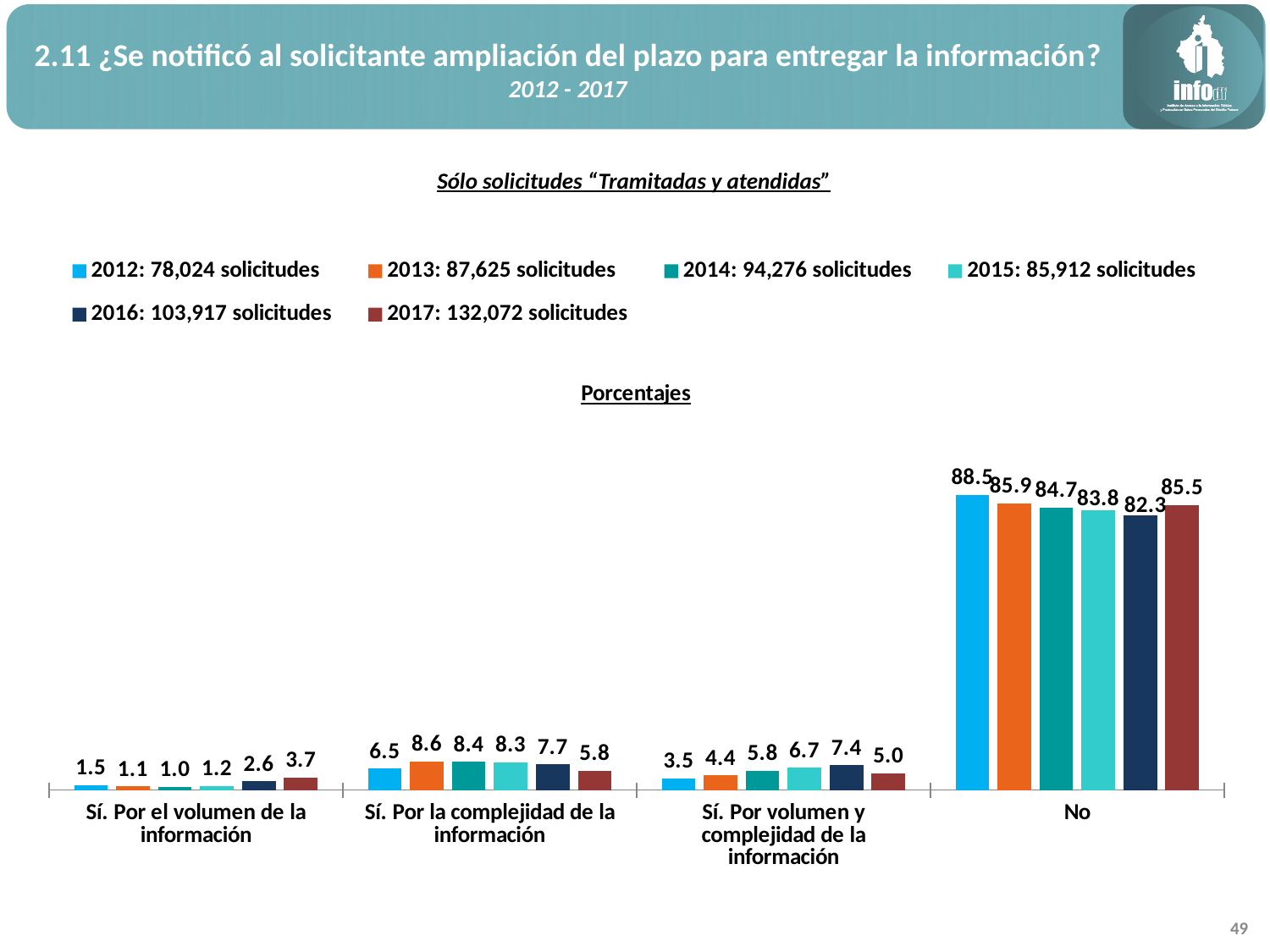
In the "Sí. Por la complejidad de la información" category, which is larger: the value for 2013 or the value for 2017? 2013 Which year has the lowest value in the "Sí. Por el volumen de la información" category? 2014 What is the value for 2012 in the "Sí. Por la complejidad de la información" category? 6.5 What is the value for 2016 in the "Sí. Por volumen y complejidad de la información" category? 7.4 Which year has the highest value in the "No" category? 2012 Do the values in the "Sí. Por el volumen de la información" category rise or fall from 2015 to 2017? Rise What is the difference between the 2012 and 2016 values in the "No" category? 6.2 How many categories are shown on the x axis of the chart? 4 What is the value for 2017 in the "No" category? 85.5 How many series does the legend list? 6 According to the legend, how many solicitudes were there in 2017? 132,072 What kind of chart is shown on the slide? Bar chart